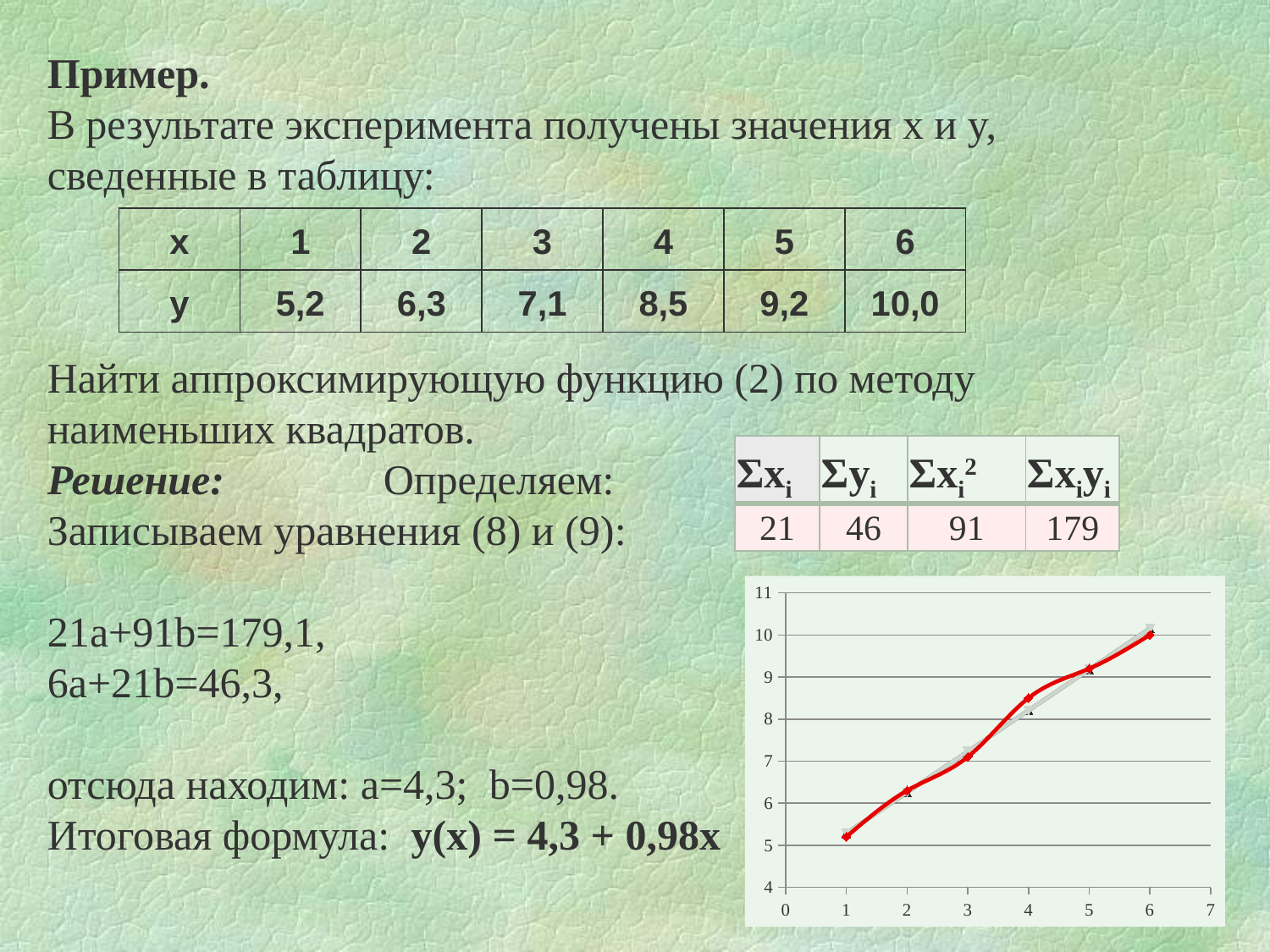
What is the highest tick value shown on the chart's y axis? 11 At which x value is the plotted y value highest? 6 Which has the larger plotted y value, x = 5 or x = 2? x = 5 Do the plotted values rise or fall as x increases along the x axis? rise How many data points are plotted on the chart? 6 Is the plotted value at x = 2 greater or less than 7? less At which x value is the plotted y value lowest? 1 What kind of chart is shown at the bottom right of the slide? line chart What is the plotted y value at x = 6? 10 Is the plotted value at x = 1 greater or less than 6? less What colour is the line connecting the data points on the chart? red Is the plotted value at x = 4 greater or less than 8? greater